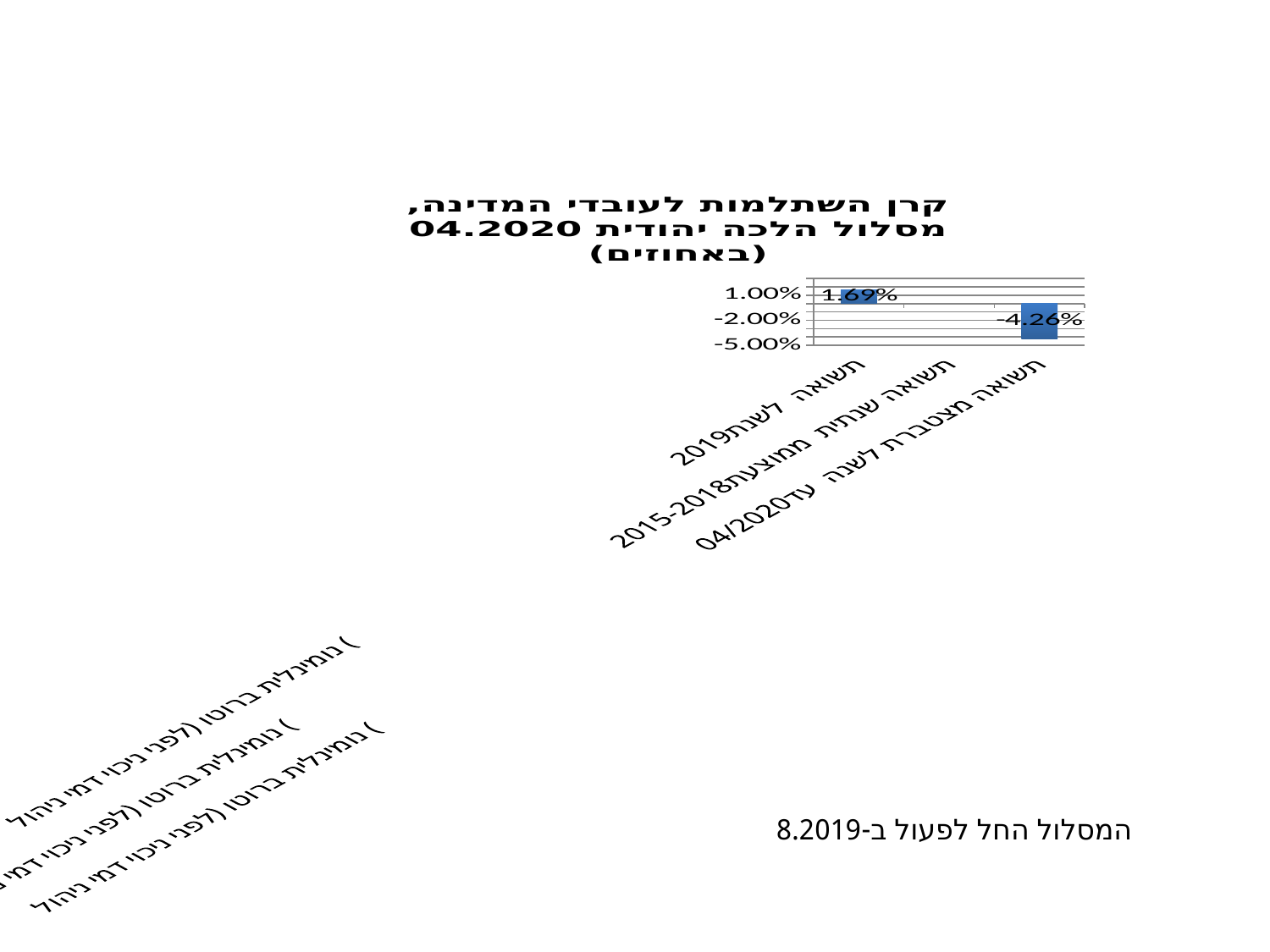
What is the difference between the value for תשואה לשנת 2019 and the value for תשואה מצטברת לשנה עד 04/2020? 5.95 percentage points Which category has the lowest value in the chart? תשואה מצטברת לשנה עד 04/2020 How many categories are shown on the x axis of the chart? 3 What is the value shown for תשואה לשנת 2019? 1.69% What kind of chart is shown on the slide? bar chart Is the value for תשואה מצטברת לשנה עד 04/2020 greater or less than -2.00%? less Which is larger: the value for תשואה לשנת 2019 or the value for תשואה מצטברת לשנה עד 04/2020? תשואה לשנת 2019 Is the value for תשואה לשנת 2019 greater or less than 1.00%? greater What is the title of the chart? קרן השתלמות לעובדי המדינה, מסלול הלכה יהודית 04.2020 (באחוזים) What is the value shown for תשואה מצטברת לשנה עד 04/2020? -4.26% Which category has the highest value in the chart? תשואה לשנת 2019 Which category in the chart has no bar plotted? תשואה שנתית ממוצעת 2015-2018